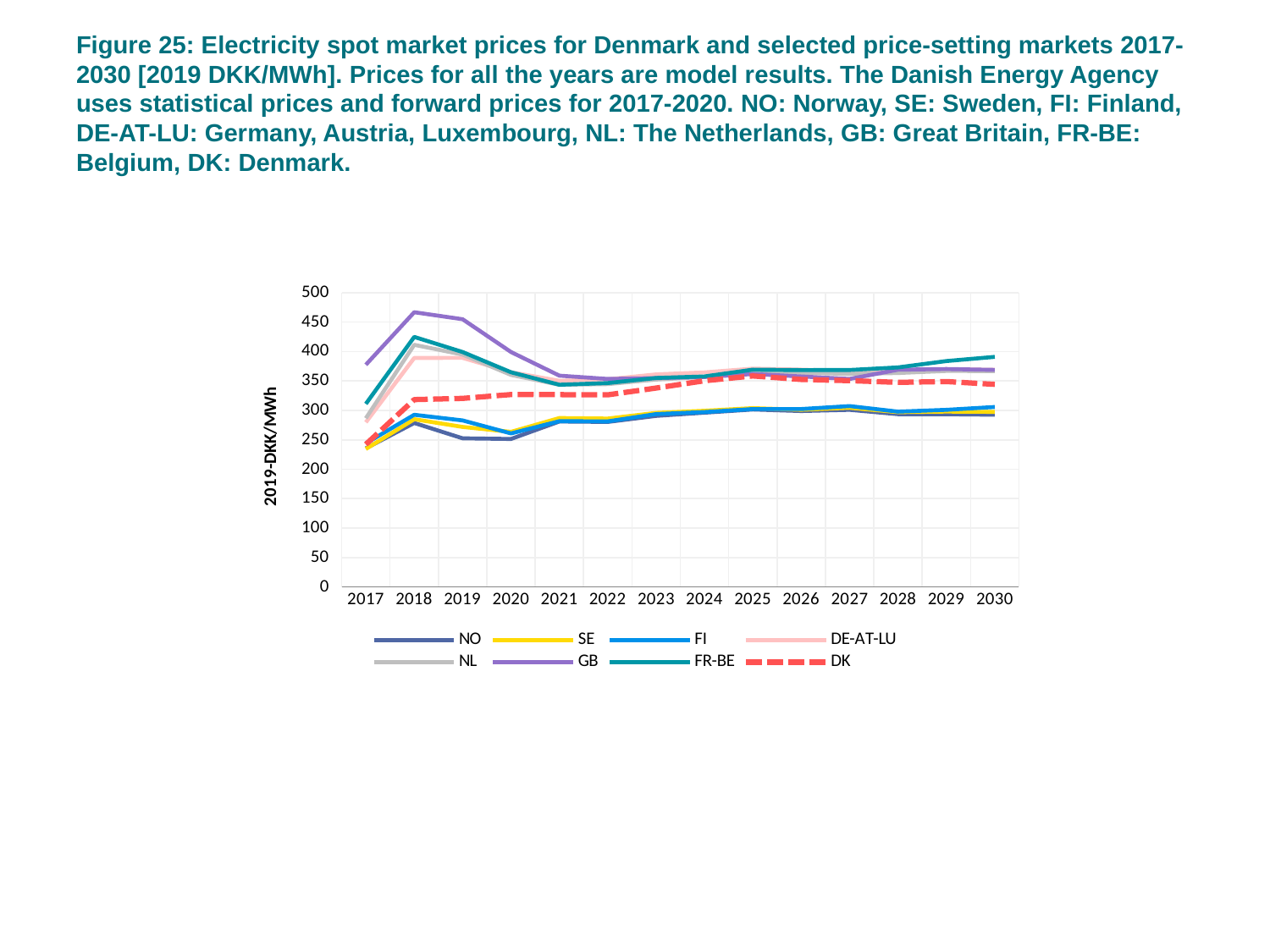
Does the GB series rise or fall from 2018 to 2021? fall Is the value for FR-BE in 2030 greater or less than 350? greater Which series is drawn with a dashed line? DK In 2025, which is larger: the value for DK or the value for NO? DK What kind of chart is shown on the slide? line chart Which series has the highest value in 2018? GB How many series does the legend list? 8 Is the value for GB in 2018 greater or less than 400? greater Is the value for DK in 2017 greater or less than 300? less How many years are shown along the x axis? 14 Which series has the highest value in 2030? FR-BE